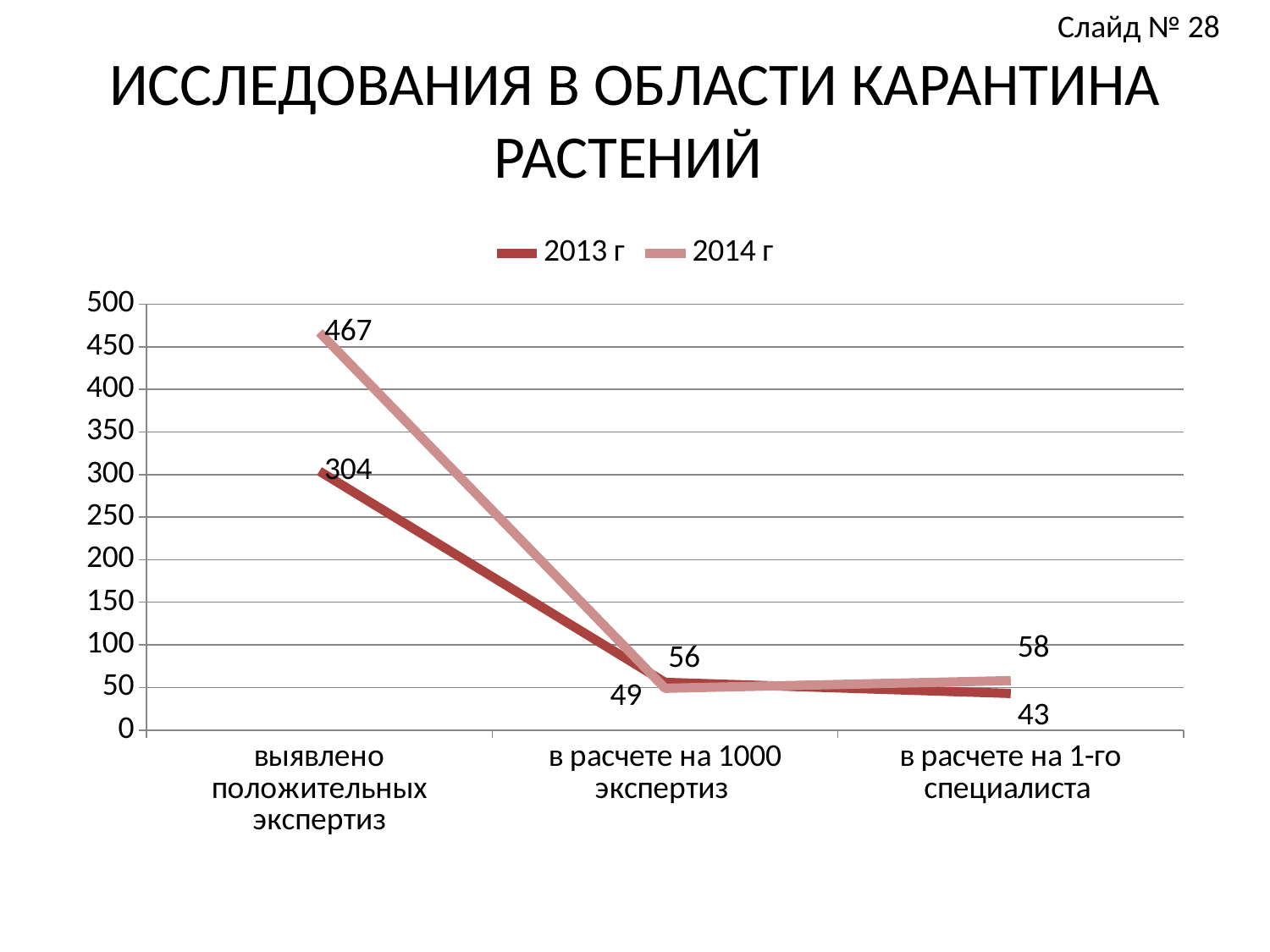
What is the value for 2014 г for "выявлено положительных экспертиз"? 467 What is the difference between the 2014 г and 2013 г values for "выявлено положительных экспертиз"? 163 What is the value for 2013 г for "выявлено положительных экспертиз"? 304 What type of chart is shown on the slide? line chart What is the value for 2013 г for "в расчете на 1000 экспертиз"? 56 How many series does the legend list? 2 Does the 2013 г series rise or fall from "выявлено положительных экспертиз" to "в расчете на 1-го специалиста"? fall Which category has the lowest value for the 2013 г series? в расчете на 1-го специалиста What is the value for 2014 г for "в расчете на 1-го специалиста"? 58 Which category has the highest value for the 2014 г series? выявлено положительных экспертиз For "в расчете на 1000 экспертиз", which series has the larger value, 2013 г or 2014 г? 2013 г How many categories are shown on the x axis? 3